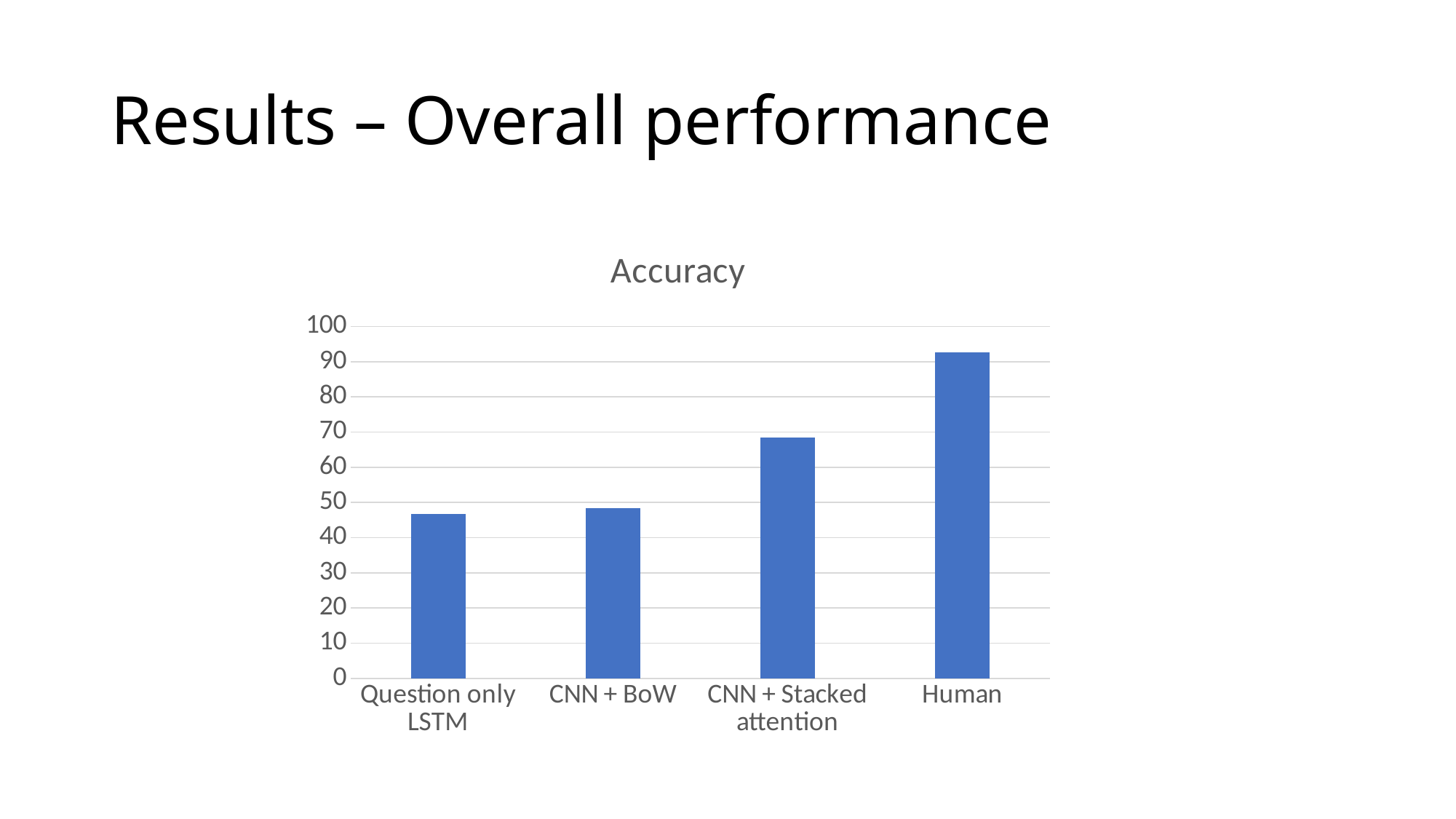
What is the title of the chart? Accuracy Which is larger, the value for Human or the value for CNN + Stacked attention? Human Do the values rise or fall from left to right along the x axis? rise How many categories are shown on the x axis of the chart? 4 What kind of chart is shown on the slide? bar chart Which is larger, the value for CNN + Stacked attention or the value for CNN + BoW? CNN + Stacked attention Is the value for Human greater or less than 80? greater Is the value for Question only LSTM greater or less than 50? less Is the value for CNN + BoW greater or less than 40? greater Which category has the highest accuracy? Human